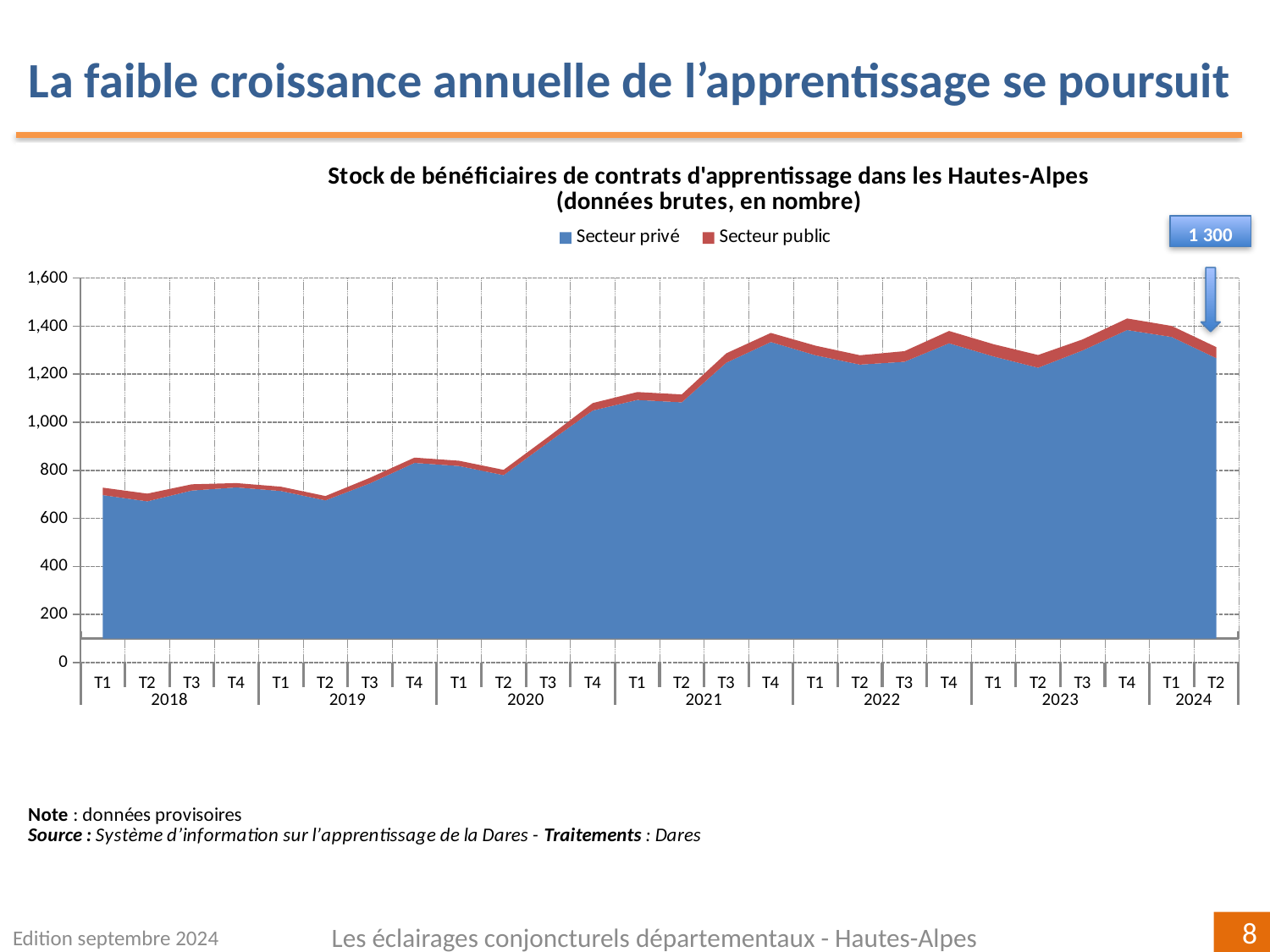
Overall, do the values rise or fall from T1 2018 to T2 2024? rise At T2 2024, which series is larger, Secteur privé or Secteur public? Secteur privé How many series does the legend list? 2 Is the total value for T4 2021 greater or less than 1,200? greater How many quarterly points are plotted along the x axis? 26 Which colour represents Secteur privé in the chart? Blue Which is larger, the total for T4 2021 or the total for T1 2018? T4 2021 Is the total value for T2 2020 greater or less than 1,000? less What total value is shown in the callout for T2 2024? 1 300 Is the total value for T1 2018 greater or less than 800? less What are the two series named in the legend? Secteur privé and Secteur public What kind of chart is shown on the slide? Area chart